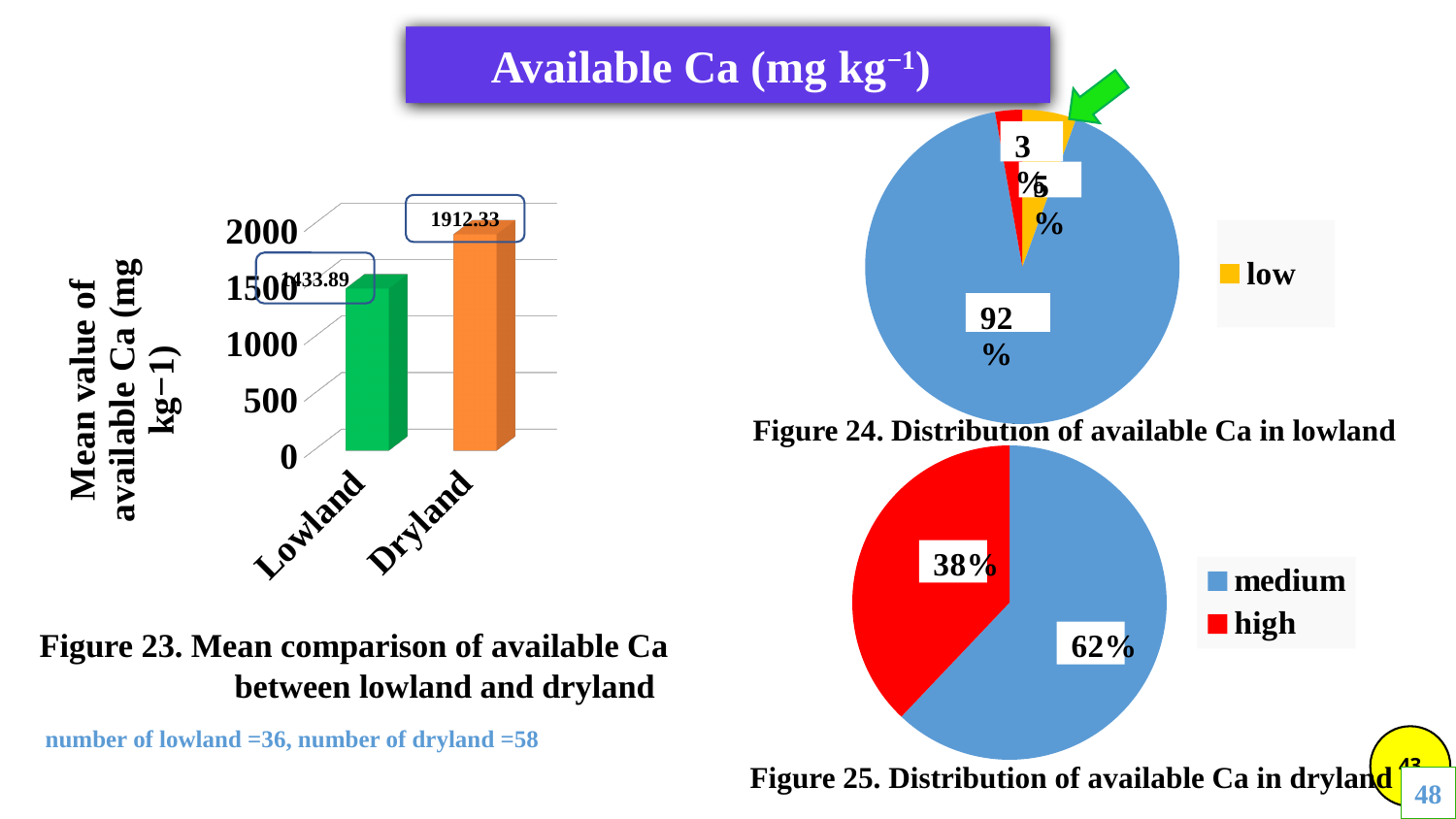
In Figure 25, which class has the larger share, medium or high? medium In Figure 23, what is the mean value of available Ca for Dryland? 1912.33 In Figure 23, what is the difference between the Dryland and Lowland mean values of available Ca? 478.44 In Figure 25, how many entries does the legend list? 2 In Figure 24, what percentage does the largest slice represent? 92% In Figure 25, what share of dryland samples is in the high class? 38% What kind of chart is Figure 23? Bar chart In Figure 23, which category has the higher mean value of available Ca? Dryland In Figure 23, what is the mean value of available Ca for Lowland? 1433.89 In Figure 23, do the values rise or fall going from Lowland to Dryland? Rise In Figure 25, what share of dryland samples is in the medium class? 62% In Figure 23, how many categories are plotted on the x axis? 2